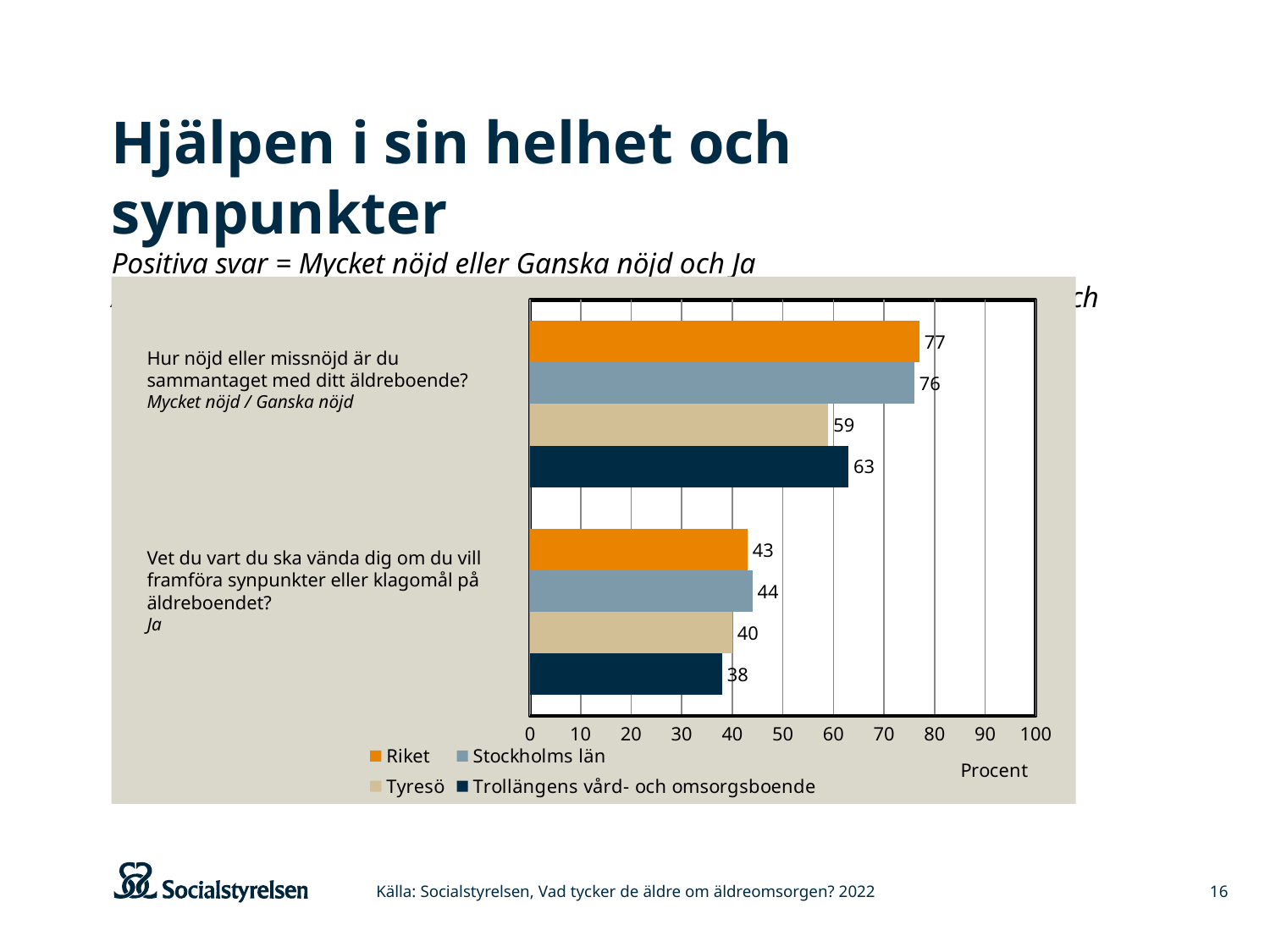
What is the label of the horizontal axis? Procent Which is larger on the question "Vet du vart du ska vända dig om du vill framföra synpunkter eller klagomål på äldreboendet?": Tyresö or Trollängens vård- och omsorgsboende? Tyresö How many questions (categories) are shown on the chart? 2 What is the value for Tyresö on the question "Hur nöjd eller missnöjd är du sammantaget med ditt äldreboende?"? 59 Which series has the lowest value on the question "Hur nöjd eller missnöjd är du sammantaget med ditt äldreboende?"? Tyresö What is the value for Riket on the question "Hur nöjd eller missnöjd är du sammantaget med ditt äldreboende?"? 77 What is the value for Stockholms län on the question "Vet du vart du ska vända dig om du vill framföra synpunkter eller klagomål på äldreboendet?"? 44 Which series has the highest value on the question "Vet du vart du ska vända dig om du vill framföra synpunkter eller klagomål på äldreboendet?"? Stockholms län What kind of chart is shown on the slide? bar chart What is the value for Trollängens vård- och omsorgsboende on the question "Vet du vart du ska vända dig om du vill framföra synpunkter eller klagomål på äldreboendet?"? 38 How many series does the legend list? 4 What is the difference between Riket and Trollängens vård- och omsorgsboende on the question "Hur nöjd eller missnöjd är du sammantaget med ditt äldreboende?"? 14